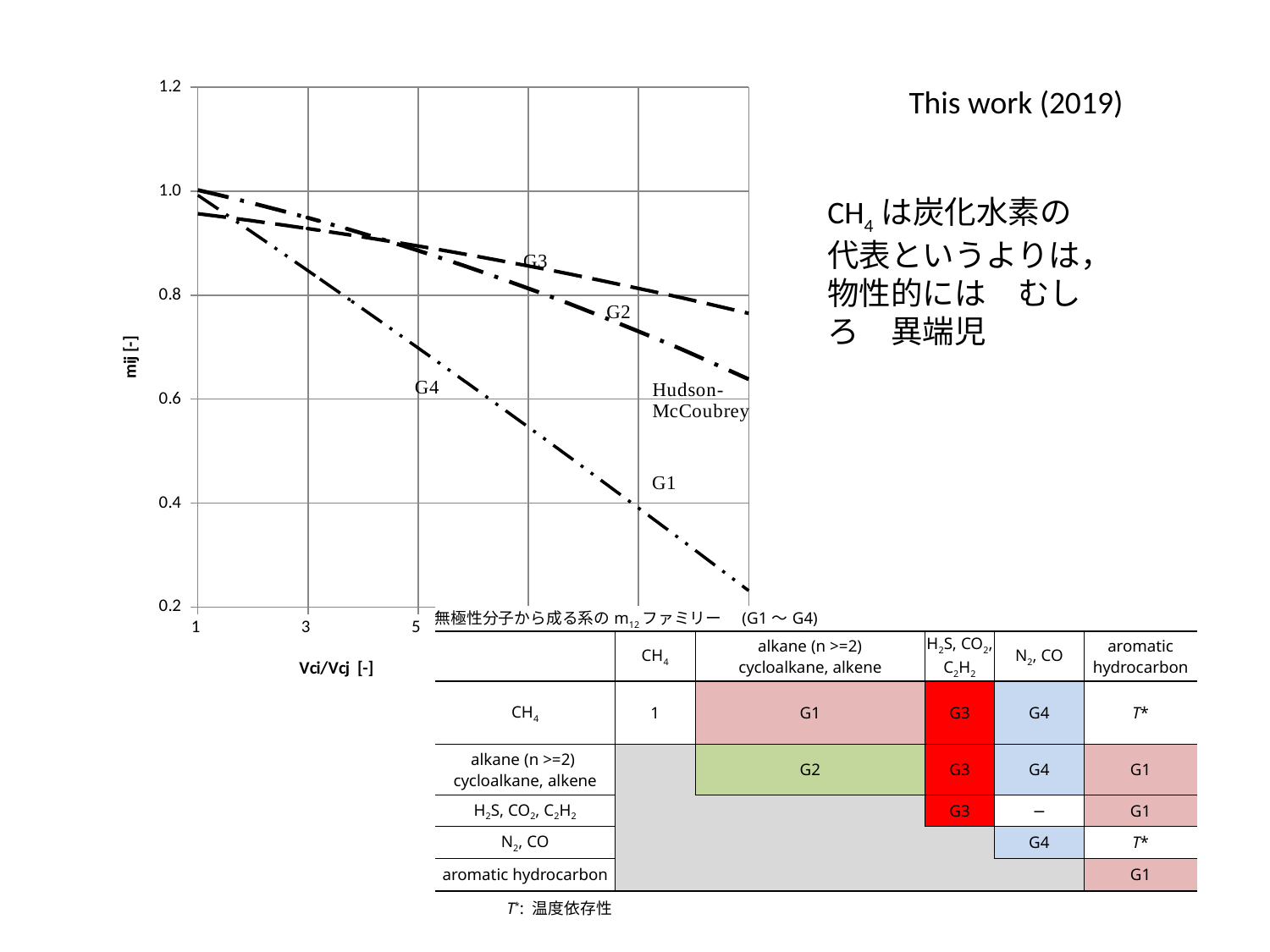
How many distinct lines are plotted on the chart? 3 At Vci/Vcj = 7, which line has the higher mij value, G3 or G2? G3 At Vci/Vcj = 5, is the value of the G3 line greater or less than 0.8? greater At Vci/Vcj = 7, is the value of the steepest (dash-dot-dot) line greater or less than 0.6? less What is the label of the vertical axis of the chart? mij [-] What is the label of the horizontal axis of the chart? Vci/Vcj [-] Do the plotted lines rise or fall as Vci/Vcj increases? fall What kind of chart is shown on the slide? line chart What is the highest tick value shown on the vertical axis? 1.2 At the right edge of the chart, is the value of the steepest (dash-dot-dot) line greater or less than 0.4? less What is the lowest tick value shown on the vertical axis? 0.2